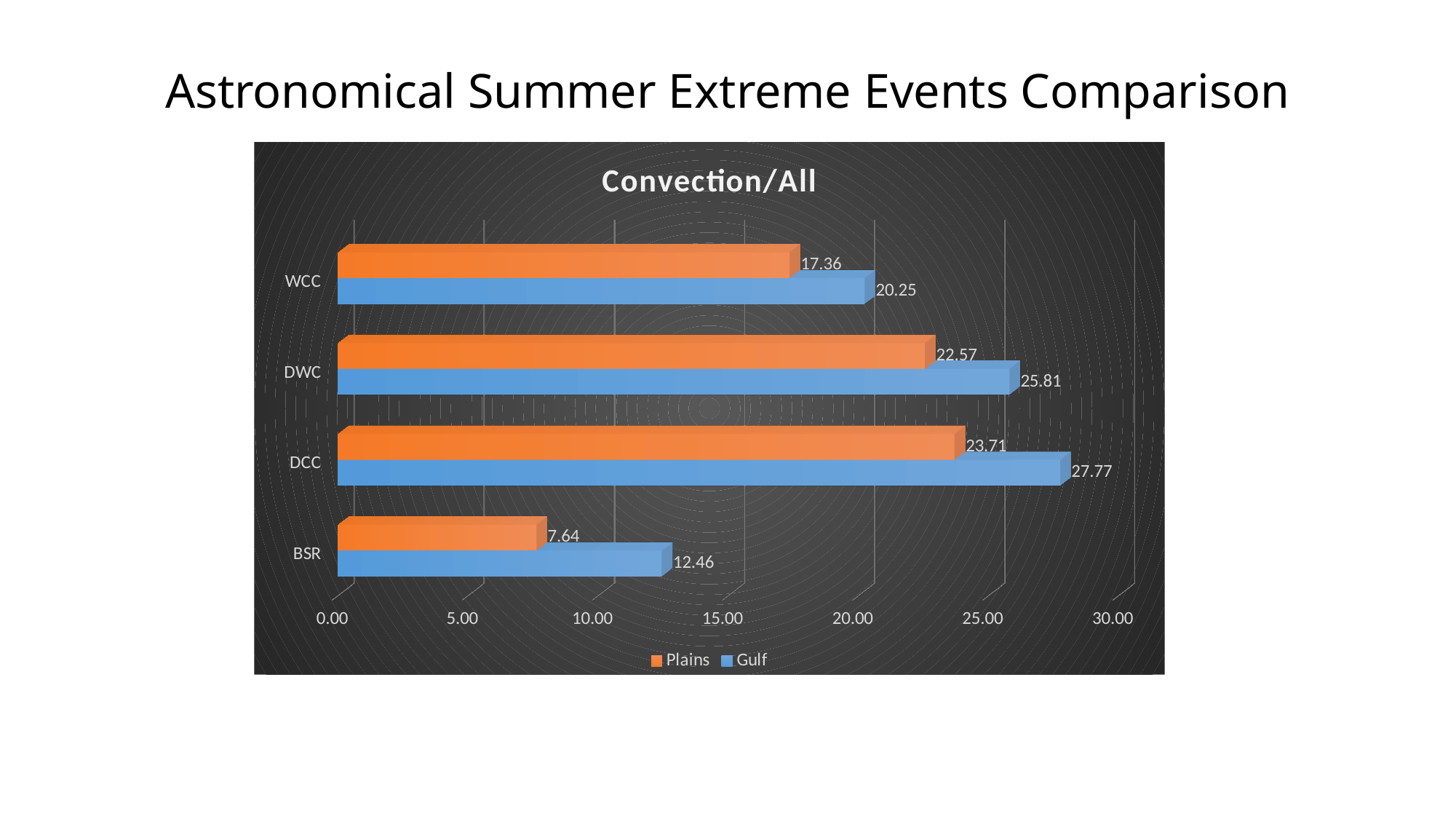
Which category has the highest Gulf value? DCC What is the Plains value for WCC? 17.36 What is the difference between the Gulf values for DCC and WCC? 7.52 What is the Gulf value for DCC? 27.77 How many categories are shown on the chart? 4 What kind of chart is shown on the slide? Bar chart How many series does the legend list? 2 Which category has the lowest Plains value? BSR What is the Gulf value for DWC? 25.81 What is the Plains value for BSR? 7.64 What is the difference between the Gulf and Plains values for BSR? 4.82 Which is larger for DWC, the Plains value or the Gulf value? Gulf